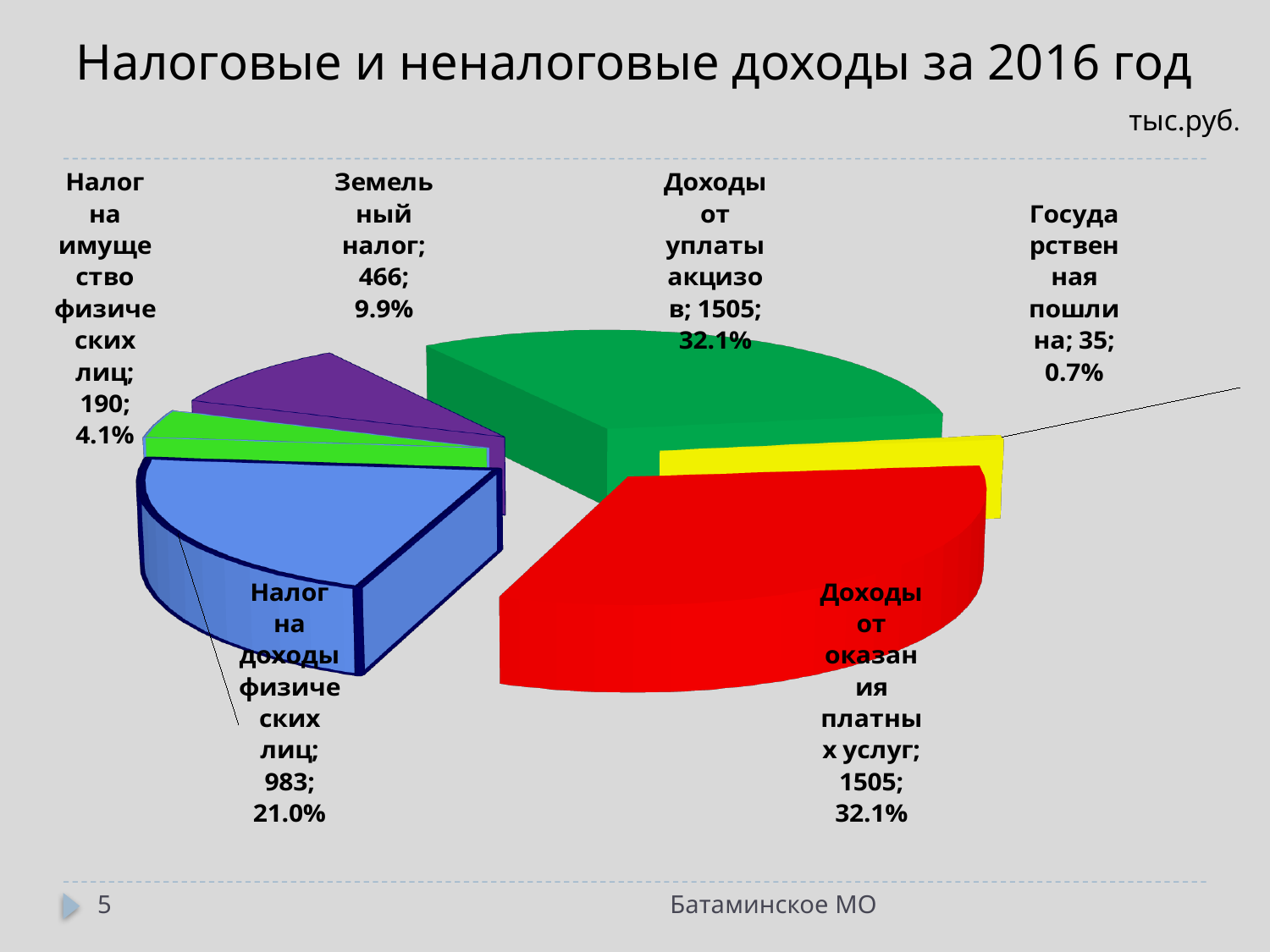
What is the value for Налог на доходы физических лиц? 983 What is the value for Доходы от уплаты акцизов? 1505 Which category has the smallest slice? Государственная пошлина What is the title of the chart? Налоговые и неналоговые доходы за 2016 год What is the value for Государственная пошлина? 35 What share of the pie does Налог на имущество физических лиц represent? 4.1% What kind of chart is shown on the slide? pie chart Which is larger, Земельный налог or Налог на имущество физических лиц? Земельный налог What is the difference between the values for Налог на доходы физических лиц and Земельный налог? 517 What is the value for Земельный налог? 466 What share of the pie does Налог на доходы физических лиц represent? 21.0% How many slices does the pie chart have? 6